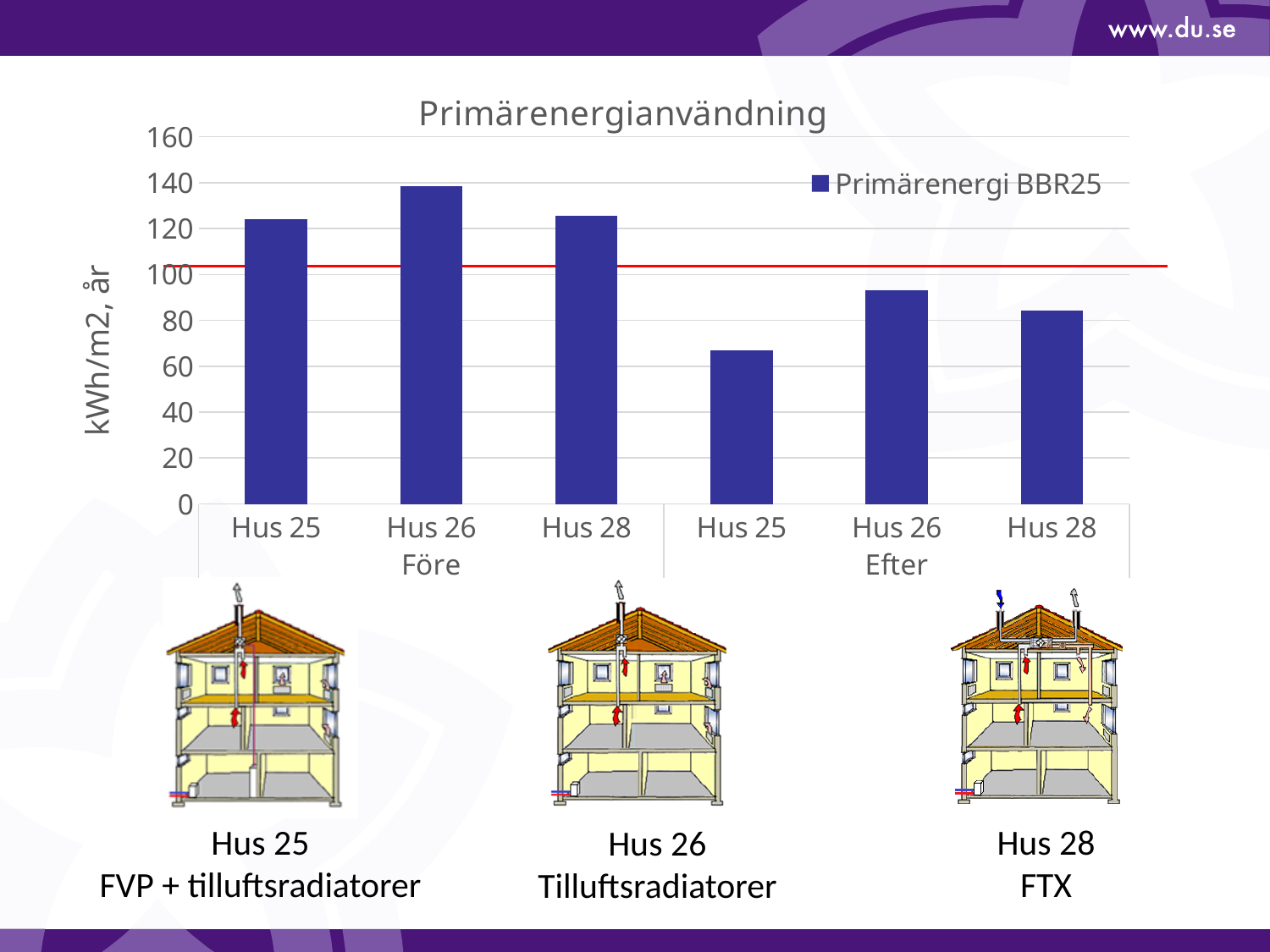
Is the value for Hus 26 under Efter greater or less than 100? less Which is larger, the value for Hus 25 under Före or the value for Hus 25 under Efter? Hus 25 under Före How many bars are plotted in the chart? 6 Which is larger, the value for Hus 26 under Efter or the value for Hus 28 under Efter? Hus 26 under Efter Which bar is the lowest in the chart? Hus 25 (Efter) What is the label on the vertical axis of the chart? kWh/m2, år What is the title of the chart? Primärenergianvändning Which bar is the highest in the chart? Hus 26 (Före) What kind of chart is shown on the slide? bar chart How many series does the legend list? 1 Is the value for Hus 26 under Före greater or less than 120? greater Is the value for Hus 25 under Efter greater or less than 80? less